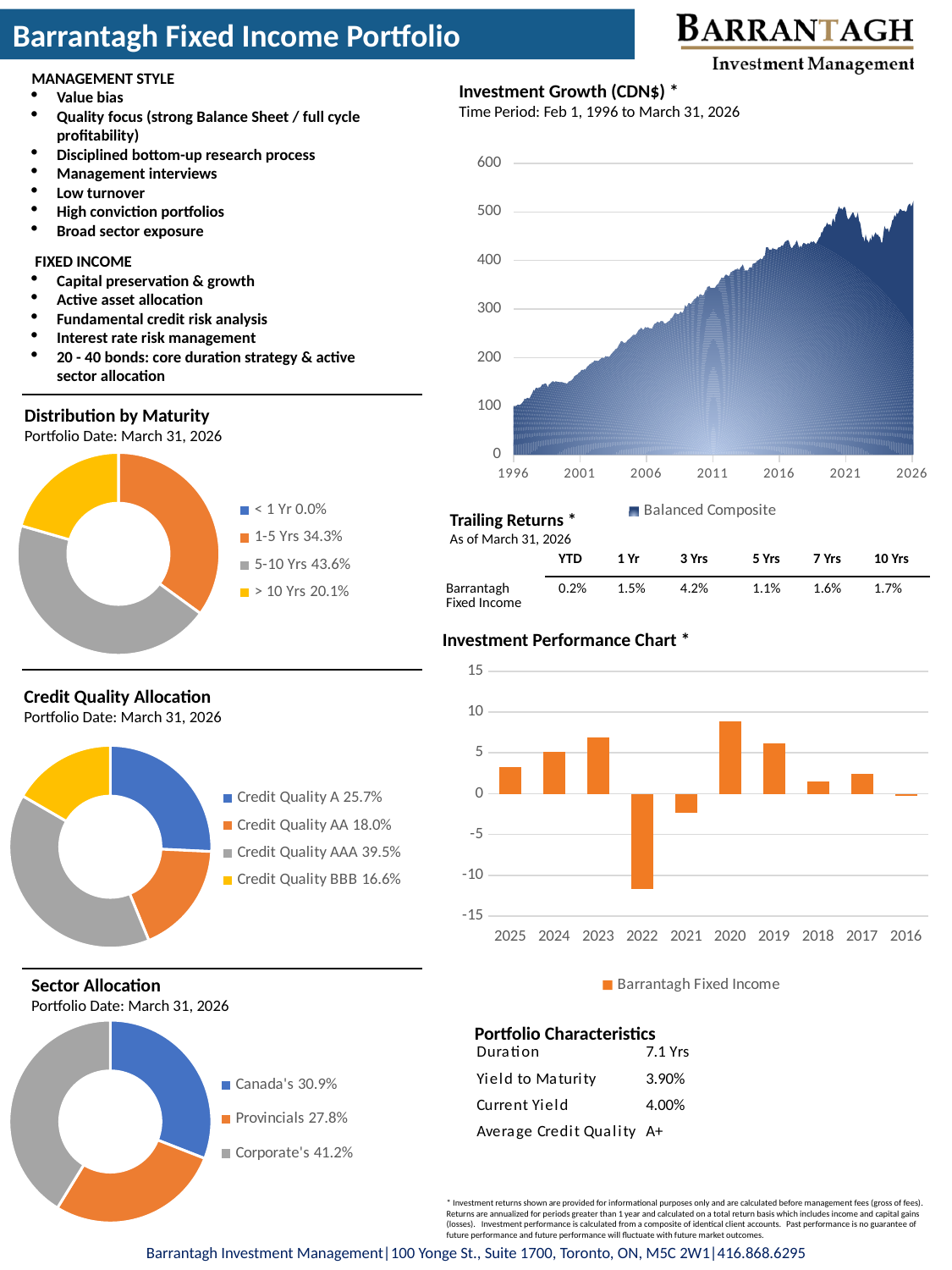
In the Investment Performance Chart, is the value for 2020 greater or less than 5? greater In the Credit Quality Allocation chart, what is the share for Credit Quality AAA? 39.5% In the Investment Performance Chart, which year has the lowest value? 2022 In the Distribution by Maturity chart, what share of the portfolio is in the 5-10 Yrs bucket? 43.6% In the Sector Allocation chart, what is the share for Corporate's? 41.2% In the Credit Quality Allocation chart, which credit quality category has the smallest share? Credit Quality BBB In the Distribution by Maturity chart, which maturity bucket has the largest share? 5-10 Yrs In the Credit Quality Allocation chart, what is the difference in percentage points between Credit Quality AAA and Credit Quality A? 13.8 In the Investment Growth (CDN$) chart, which series does the legend list? Balanced Composite What kind of chart is the Investment Performance Chart? bar chart How many categories does the Sector Allocation chart show? 3 In the Distribution by Maturity chart, what is the share for < 1 Yr? 0.0%